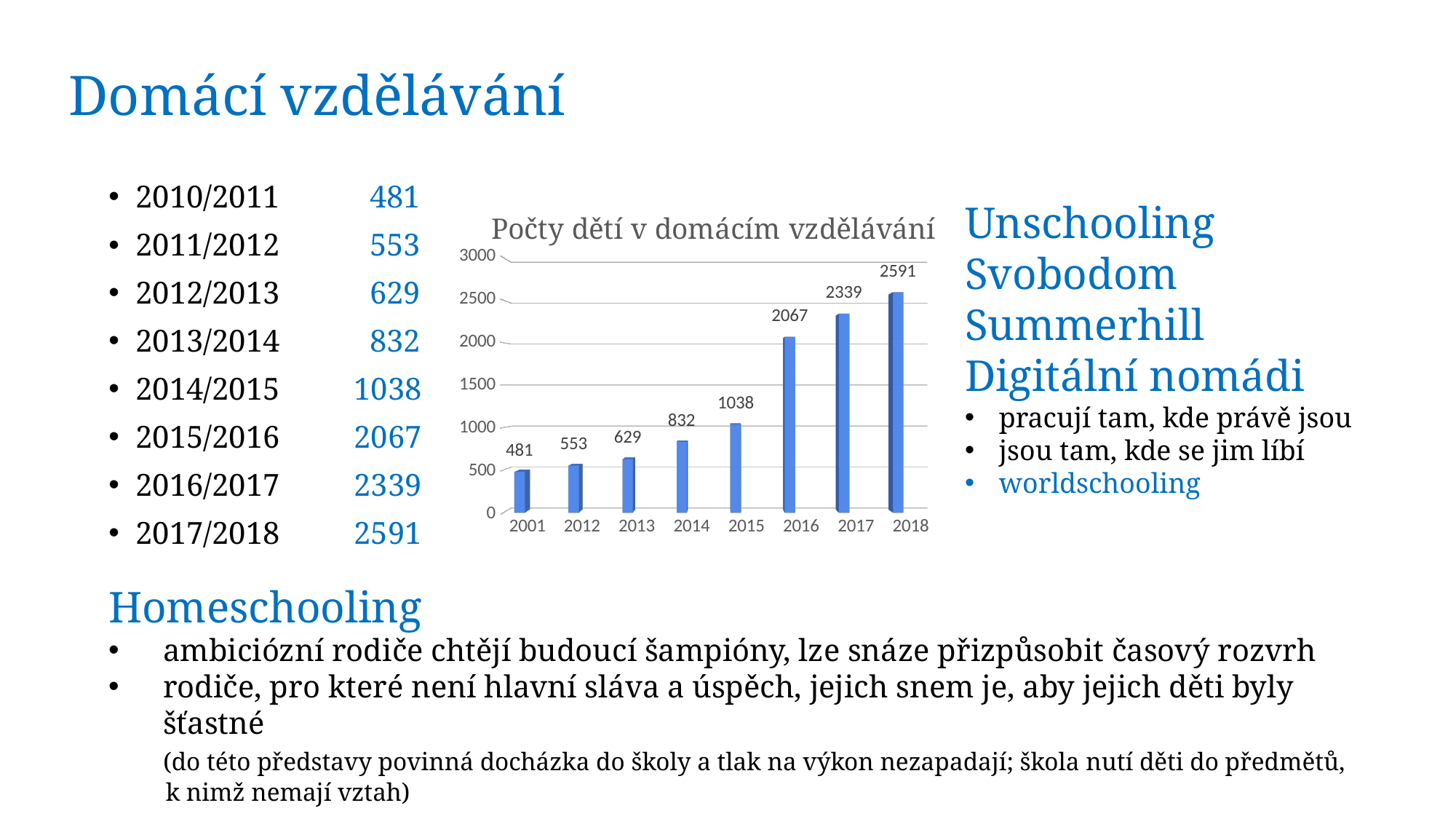
What is the difference between the values for 2018 and 2017? 252 What is the difference between the values for 2016 and 2015? 1029 What kind of chart is shown on the slide? bar chart What is the title of the chart? Počty dětí v domácím vzdělávání What is the value for 2016 in the chart? 2067 What is the value for 2014 in the chart? 832 Which is larger, the value for 2013 or the value for 2015? 2015 How many bars are in the chart? 8 Is the value for 2017 greater or less than 2000? greater Which category has the highest value in the chart? 2018 What is the value for 2001 in the chart? 481 Which category has the lowest value in the chart? 2001